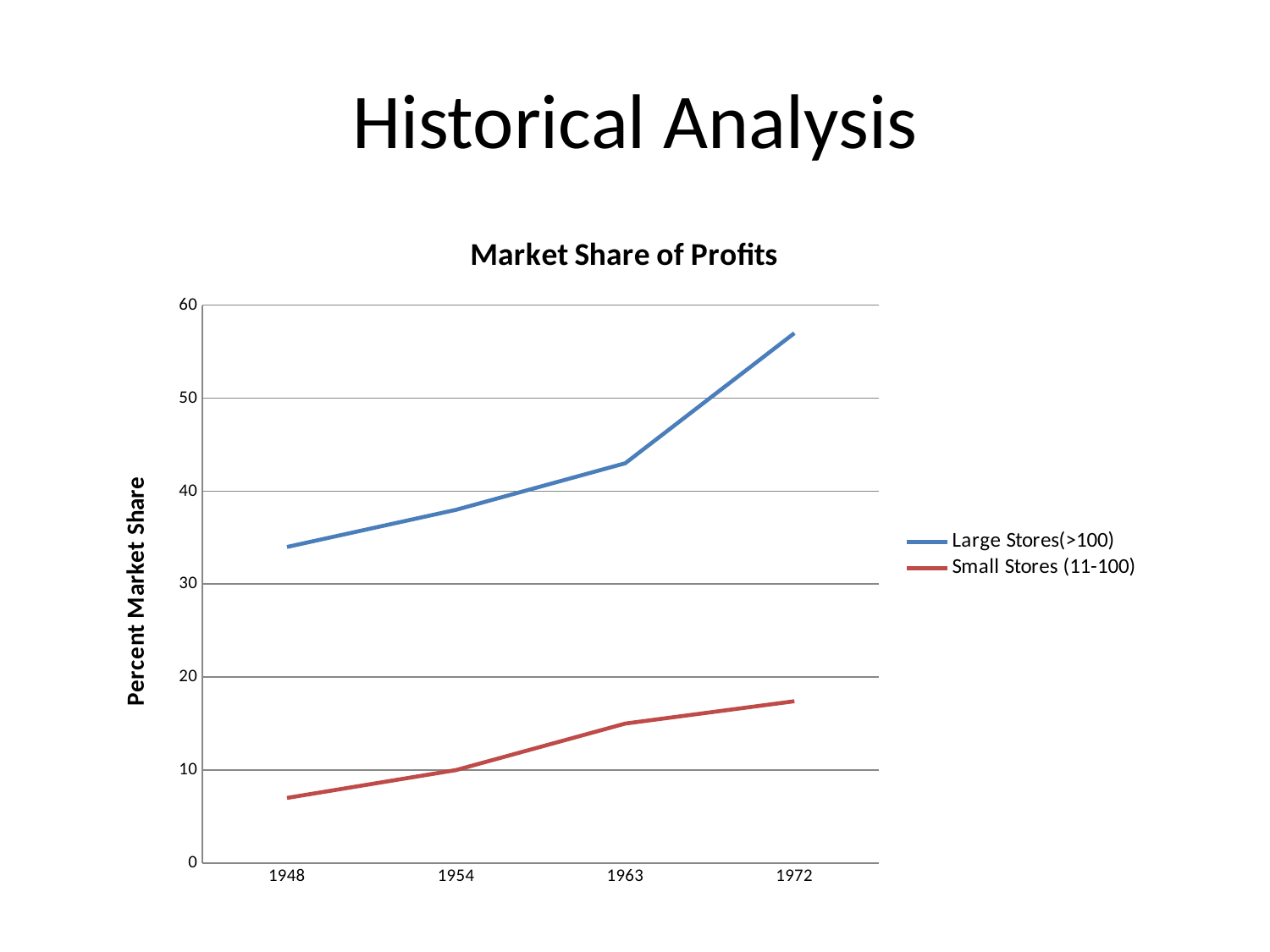
What type of chart is shown on the slide? line chart Which series has the larger value in 1972, Large Stores(>100) or Small Stores (11-100)? Large Stores(>100) How many years are plotted along the x axis? 4 How many series does the legend list? 2 In which year is the value for Small Stores (11-100) lowest? 1948 Is the value for Large Stores(>100) in 1972 greater or less than 50? greater In which year does Large Stores(>100) reach its highest value? 1972 Do the values for Large Stores(>100) rise or fall from 1948 to 1972? rise Is the value for Small Stores (11-100) in 1963 greater or less than 10? greater Is the value for Large Stores(>100) in 1948 greater or less than 40? less